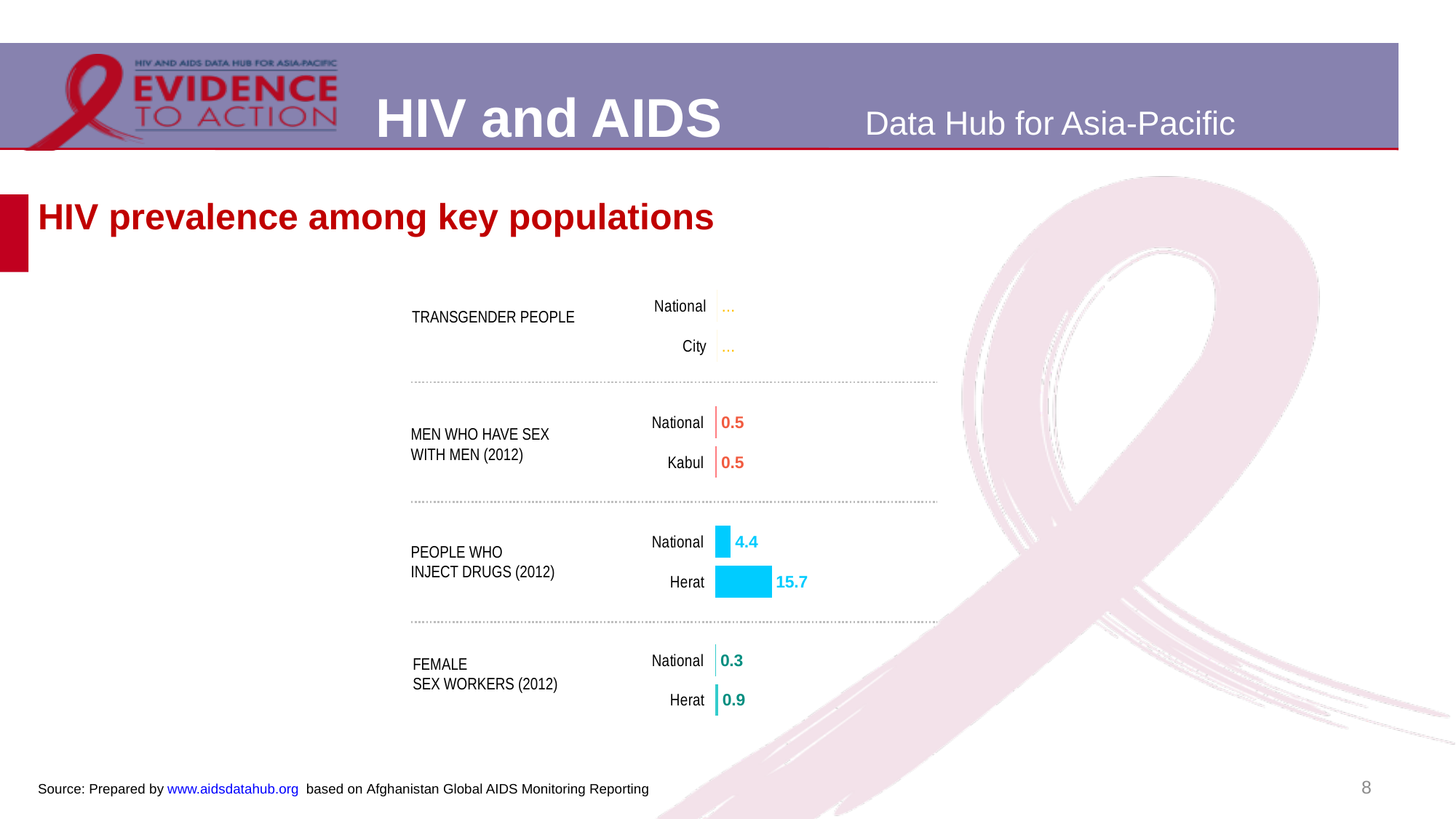
What is the national HIV prevalence among people who inject drugs? 4.4 What is the national HIV prevalence among female sex workers? 0.3 What is the HIV prevalence among people who inject drugs in Herat? 15.7 What is the HIV prevalence among female sex workers in Herat? 0.9 What is the difference between the Herat and national HIV prevalence among female sex workers? 0.6 What value is shown for transgender people at the national level? ... What kind of chart is used to show HIV prevalence among key populations? Bar chart What is the difference between the Herat and national HIV prevalence among people who inject drugs? 11.3 Which key population and location has the highest HIV prevalence shown on the chart? People who inject drugs, Herat What is the national HIV prevalence among men who have sex with men? 0.5 Which is larger: the HIV prevalence among female sex workers in Herat or the national figure for female sex workers? Herat How many key population groups are listed on the chart? 4